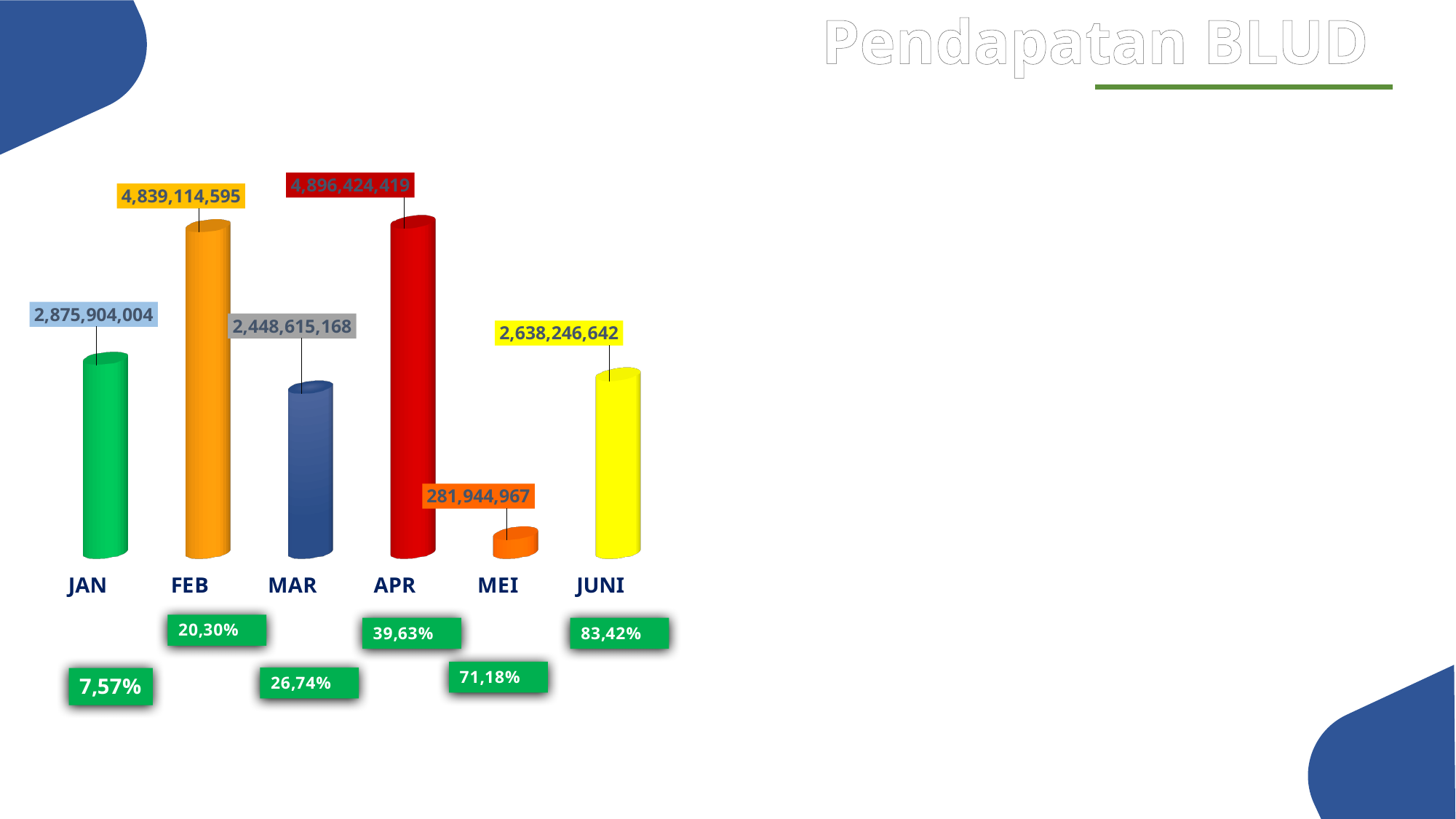
What is the title of the slide containing the chart? Pendapatan BLUD How many months are shown on the chart? 6 What is the difference between the values for APR and FEB? 57,309,824 What is the difference between the values for JAN and MAR? 427,288,836 Which month has the highest value? APR What percentage is shown below the JUNI bar? 83,42% What is the value for FEB? 4,839,114,595 Which is larger, the value for JAN or the value for JUNI? JAN What kind of chart is shown on the slide? Bar chart Which month has the lowest value? MEI What is the value for MEI? 281,944,967 What is the value for JUNI? 2,638,246,642